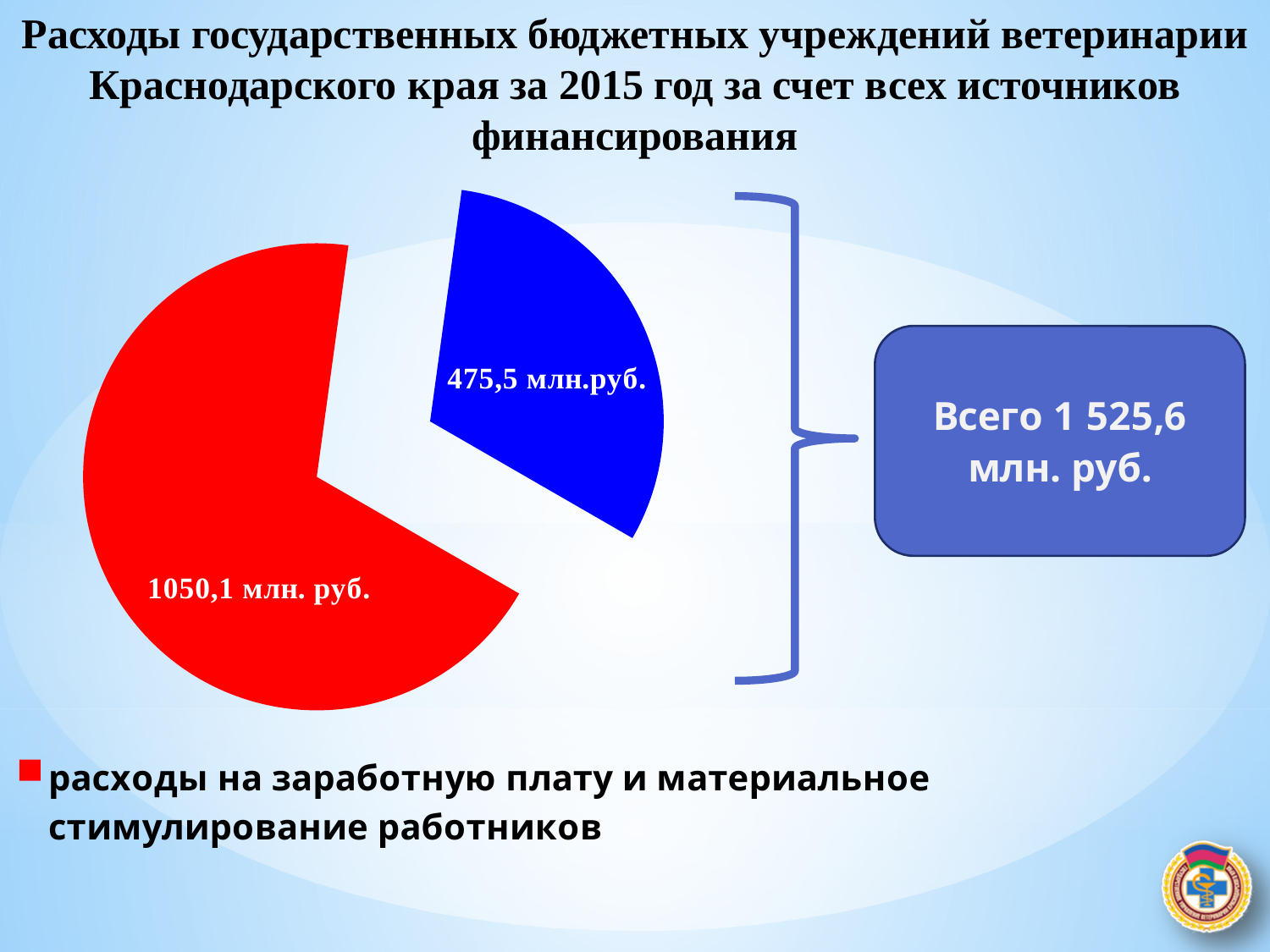
Каким цветом на диаграмме показаны расходы на заработную плату и материальное стимулирование работников? красным Сколько секторов на круговой диаграмме? 2 На сколько расходы на заработную плату и материальное стимулирование работников (1050,1 млн. руб.) превышают значение синего сектора (475,5 млн. руб.)? 574,6 млн. руб. Сколько элементов перечислено в легенде диаграммы? 1 Какой сектор диаграммы самый маленький? синий сектор (475,5 млн.руб.) Каков размер расходов на заработную плату и материальное стимулирование работников? 1050,1 млн. руб. Какой тип диаграммы показан на слайде? круговая диаграмма Какой сектор диаграммы самый большой? расходы на заработную плату и материальное стимулирование работников (1050,1 млн. руб.) Какова общая сумма расходов, указанная на слайде? 1 525,6 млн. руб. Какое значение указано на синем секторе диаграммы? 475,5 млн.руб. За какой год показаны расходы государственных бюджетных учреждений ветеринарии Краснодарского края? 2015 Что больше: расходы на заработную плату и материальное стимулирование работников или значение синего сектора? расходы на заработную плату и материальное стимулирование работников